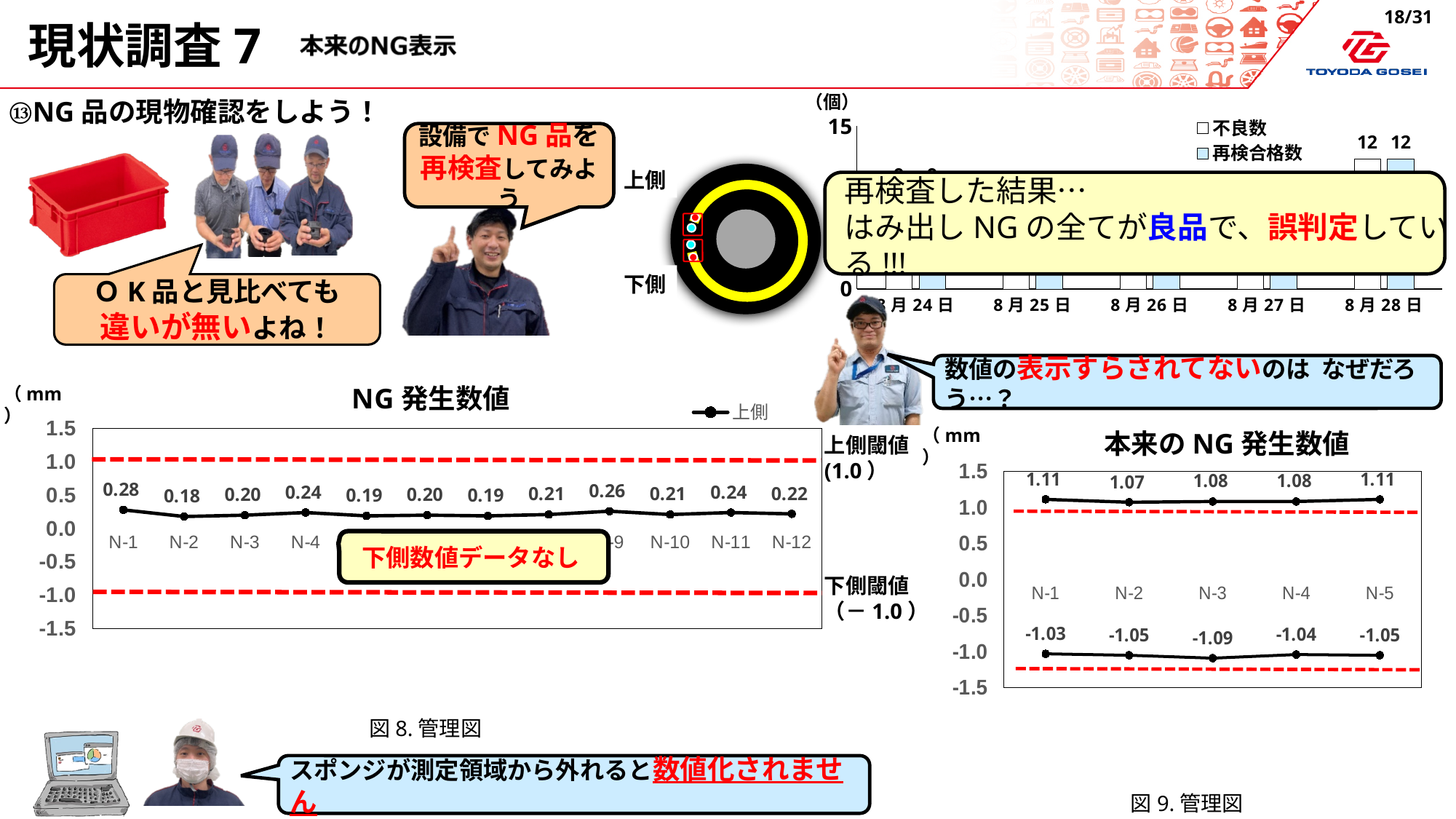
In the bar chart at the top right of the slide, how many series does the legend list? 2 In the chart titled NG 発生数値, which category has the highest value? N-1 In the chart titled 本来の NG 発生数値, how many categories are shown on the x axis? 5 In the chart titled NG 発生数値, what is the value for N-9? 0.26 In the chart titled NG 発生数値, how many data points are plotted? 12 In the chart titled NG 発生数値, what is the difference between the values for N-1 and N-2? 0.10 In the chart titled 本来の NG 発生数値, what is the upper-line value for N-2? 1.07 In the chart titled NG 発生数値, what is the value for N-1? 0.28 In the chart titled NG 発生数値, which category has the lowest value? N-2 In the chart titled 本来の NG 発生数値, what is the lower-line value for N-3? -1.09 What kind of chart is the chart titled NG 発生数値? line chart In the chart titled 本来の NG 発生数値, which category has the lowest value on the lower line? N-3